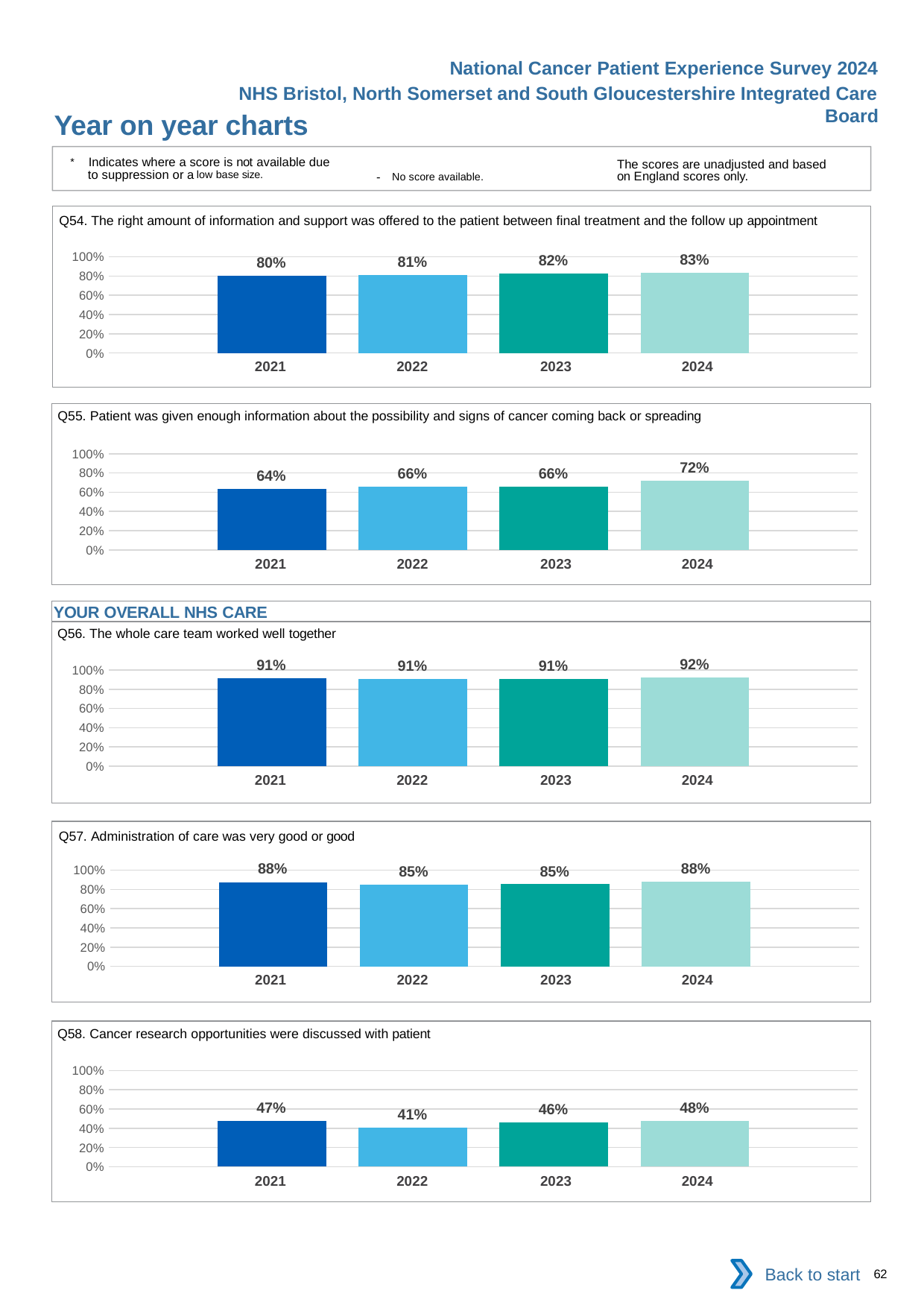
How many years are shown in the Q57 chart? 4 In the Q54 chart, do the values rise or fall from 2021 to 2024? rise What kind of chart is the Q56 chart? bar chart In the Q58 chart, what is the difference between the 2021 and 2022 values? 6% In the Q56 chart, which year has the highest value? 2024 In the Q58 chart, which year has the lowest value? 2022 In the Q54 chart, what is the value for 2024? 83% In the Q55 chart, what is the value for 2021? 64% In the Q58 chart, is the value for 2024 greater or less than 60%? less In the Q55 chart, what is the difference between the 2024 and 2023 values? 6% In the Q57 chart, is the value for 2021 larger or smaller than the value for 2023? larger In the Q57 chart, what is the value for 2022? 85%